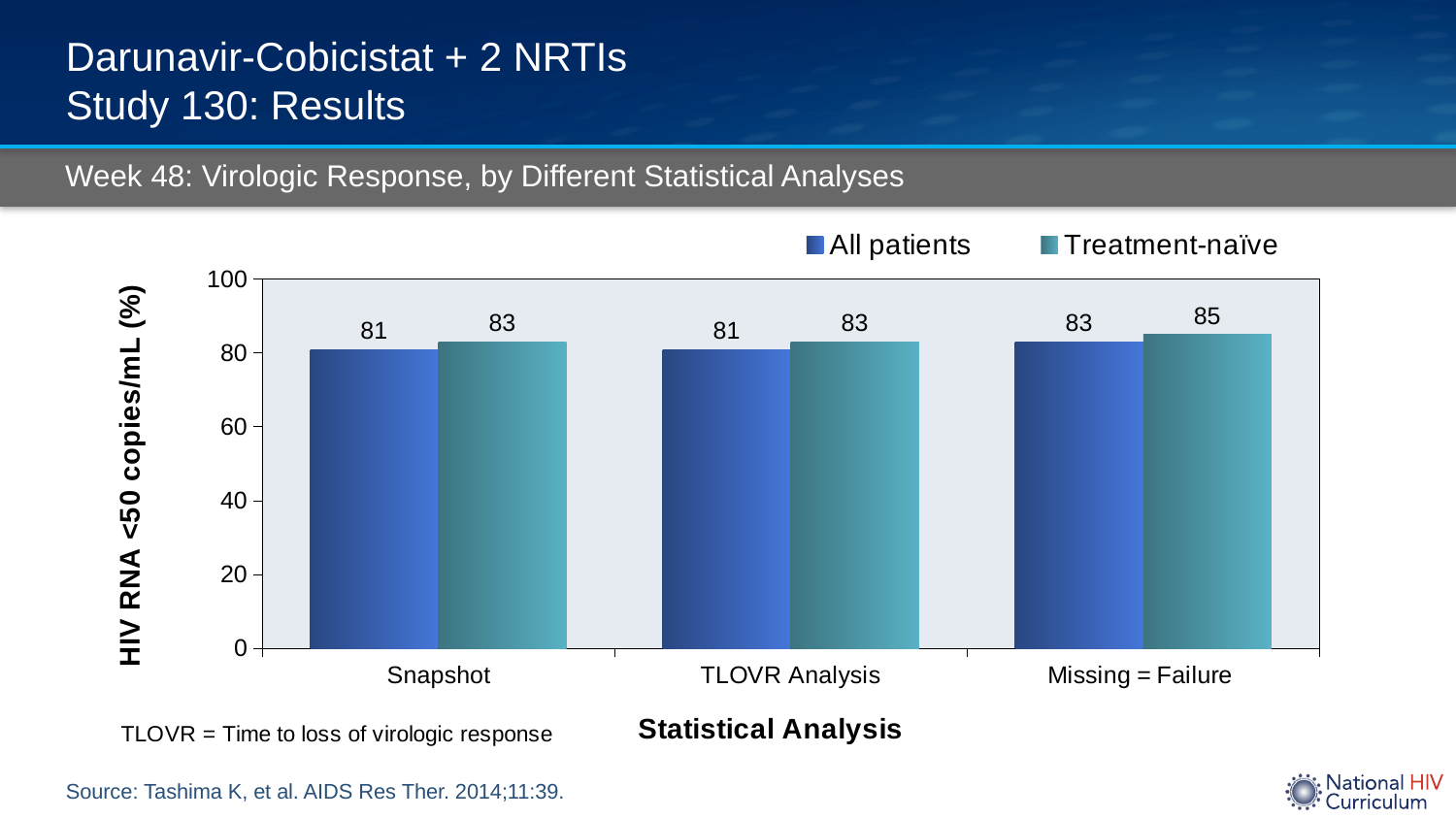
What is the difference between the Treatment-naïve values for Missing = Failure and Snapshot? 2 How many statistical analysis categories are shown on the x axis? 3 Which is larger in the Snapshot analysis: All patients or Treatment-naïve? Treatment-naïve What kind of chart is shown on the slide? Bar chart What is the value for Treatment-naïve in the Missing = Failure analysis? 85 What is the difference between the Treatment-naïve and All patients values in the Missing = Failure analysis? 2 What is the value for All patients in the Snapshot analysis? 81 What is the label of the y axis? HIV RNA <50 copies/mL (%) What is the value for Treatment-naïve in the TLOVR Analysis? 83 Which statistical analysis has the highest value for All patients? Missing = Failure How many series does the legend list? 2 Is the value for All patients in the TLOVR Analysis greater or less than 80? greater